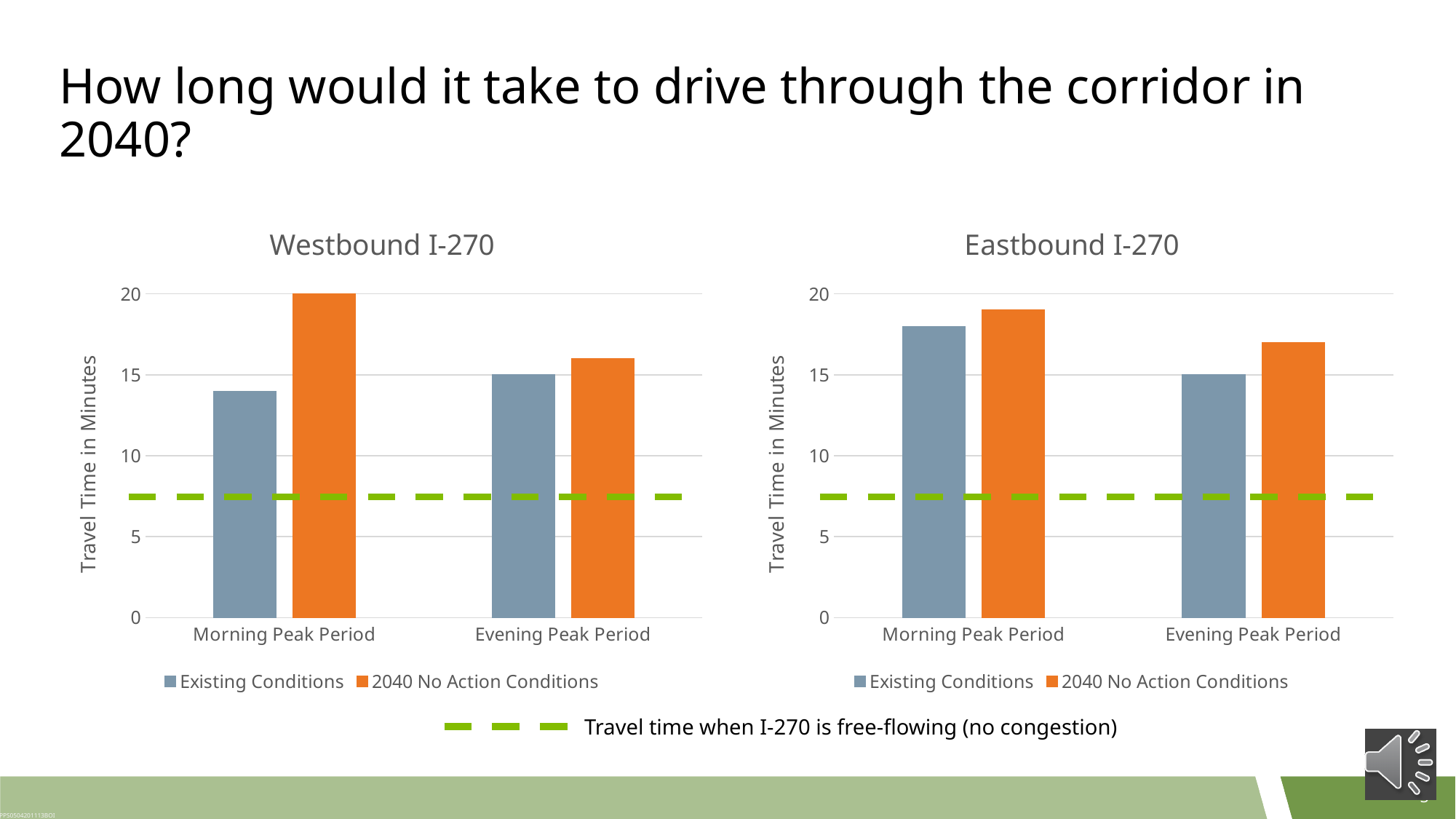
In the Westbound I-270 chart, which bar is the tallest? 2040 No Action Conditions, Morning Peak Period In the Westbound I-270 chart, which is larger for the Morning Peak Period: Existing Conditions or 2040 No Action Conditions? 2040 No Action Conditions In the Eastbound I-270 chart, which is larger for the Evening Peak Period: Existing Conditions or 2040 No Action Conditions? 2040 No Action Conditions In the Westbound I-270 chart, what is the travel time for Existing Conditions in the Evening Peak Period? 15 In the Westbound I-270 chart, what is the travel time for the 2040 No Action Conditions in the Morning Peak Period? 20 What type of chart is the Westbound I-270 chart? Bar chart In the Eastbound I-270 chart, is the 2040 No Action Conditions value for the Evening Peak Period greater or less than 15? greater In the Eastbound I-270 chart, is the Existing Conditions value for the Morning Peak Period greater or less than 15? greater What does the green dashed line on the charts represent? Travel time when I-270 is free-flowing (no congestion) In the Eastbound I-270 chart, what is the travel time for Existing Conditions in the Evening Peak Period? 15 How many series does the legend of the Eastbound I-270 chart list? 2 In the Westbound I-270 chart, is the Existing Conditions value for the Morning Peak Period greater or less than 15? less